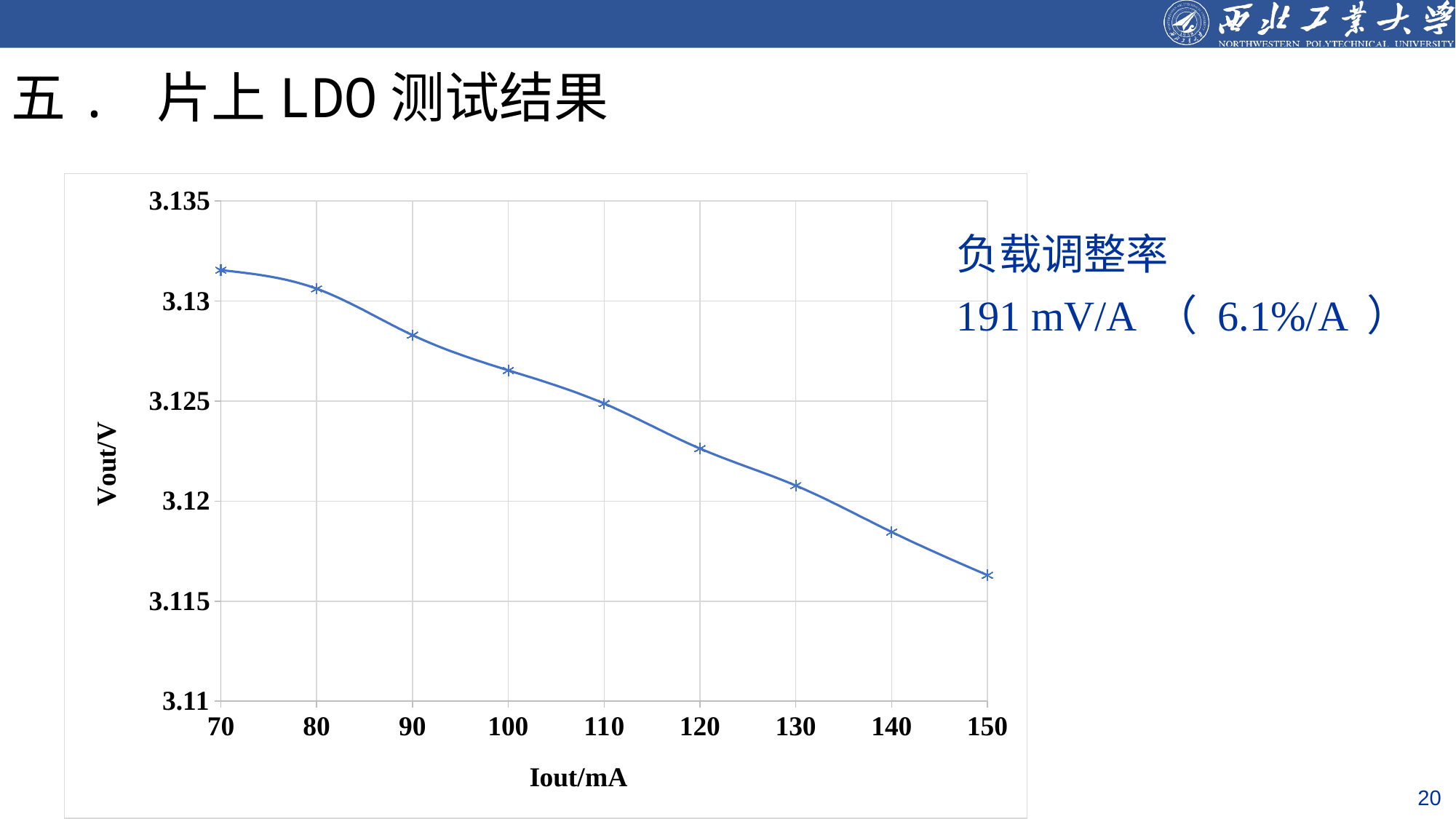
Is the Vout value at Iout = 120 mA greater or less than 3.125? less What kind of chart is shown on the slide? line chart Is the Vout value at Iout = 70 mA greater or less than 3.13? greater Is the Vout value at Iout = 150 mA greater or less than 3.115? greater At which Iout value is Vout highest? 70 At which Iout value is Vout lowest? 150 Do the Vout values rise or fall as Iout increases from 70 mA to 150 mA? fall What is the label of the vertical axis of the chart? Vout/V How many data points are plotted on the line? 9 Which has the larger Vout value: Iout = 90 mA or Iout = 130 mA? 90 mA